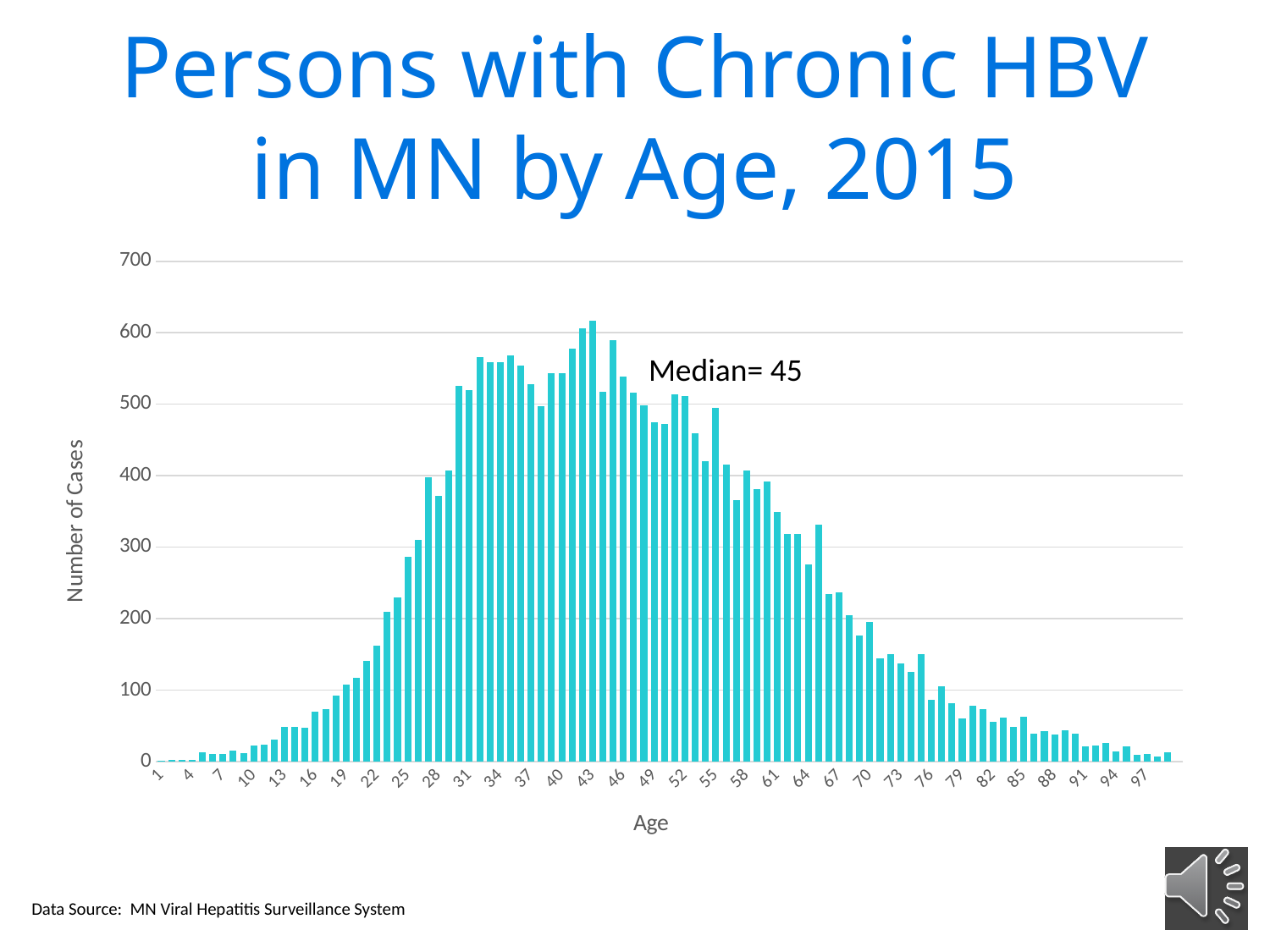
What median value is annotated on the chart? Median= 45 What kind of chart is shown on the slide? bar chart Is the number of cases for age 31 greater or less than 500? greater What is the title of the chart? Persons with Chronic HBV in MN by Age, 2015 Is the number of cases for age 64 greater or less than 300? less Which age has more cases, 22 or 58? 58 Between ages 60 and 97, do the number of cases generally rise or fall as age increases? fall Is the number of cases for age 22 greater or less than 200? less Which age has more cases, 31 or 70? 31 Between ages 1 and 31, do the number of cases generally rise or fall as age increases? rise